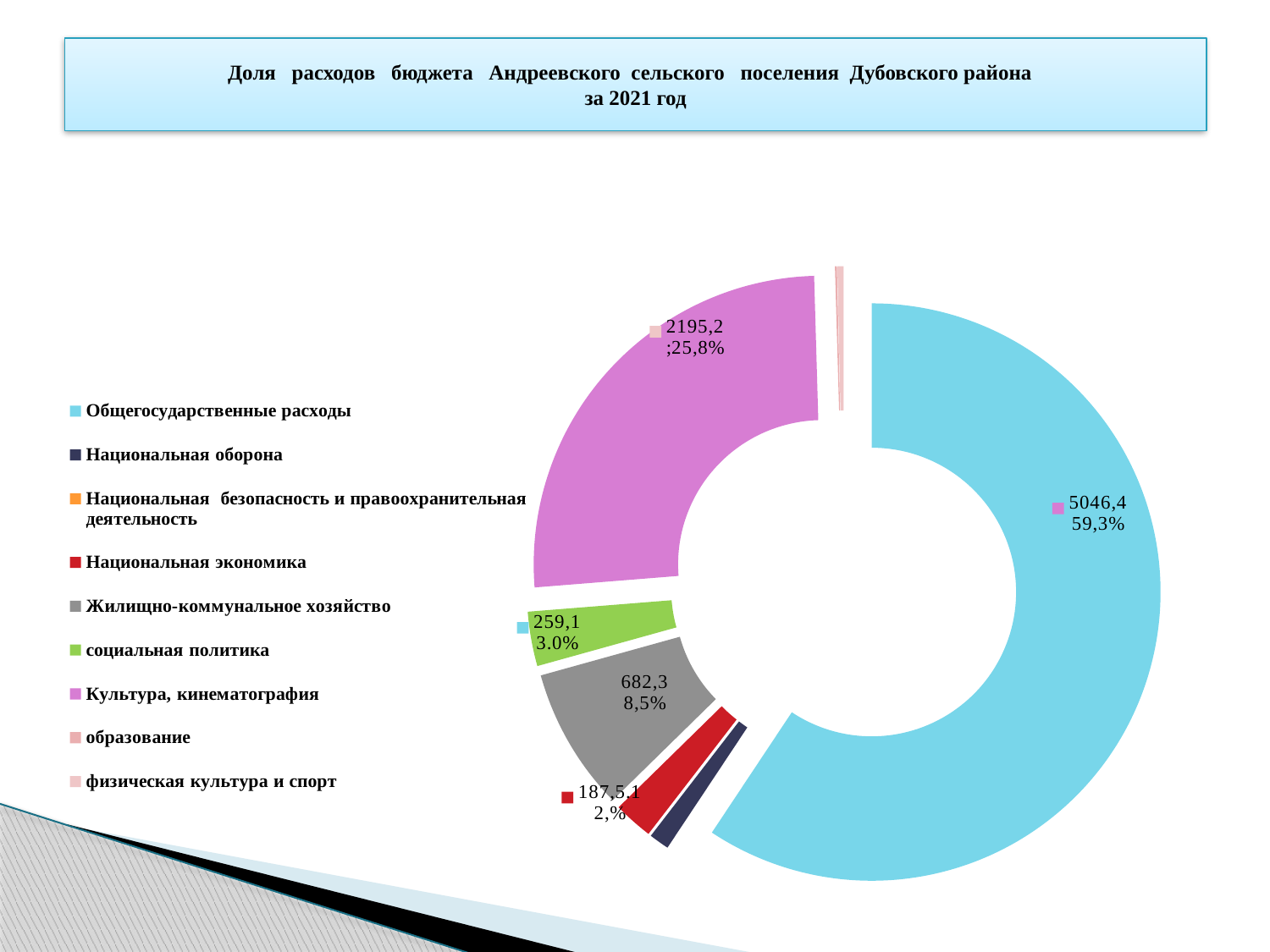
What value is printed for социальная политика? 259,1 What is the difference in percentage points between the shares of Общегосударственные расходы and Культура, кинематография? 33,5% Which is larger: Культура, кинематография or Жилищно-коммунальное хозяйство? Культура, кинематография What kind of chart is shown on the slide? pie chart (doughnut) What year does the chart title refer to? 2021 How many categories does the legend list? 9 What value is printed for the Культура, кинематография slice? 2195,2 What value and share are printed for Жилищно-коммунальное хозяйство? 682,3; 8,5% What value is printed for the Общегосударственные расходы slice? 5046,4 What share of expenditures is shown for Общегосударственные расходы? 59,3% What share is shown for Культура, кинематография? 25,8% Which category has the largest share of the budget expenditures? Общегосударственные расходы